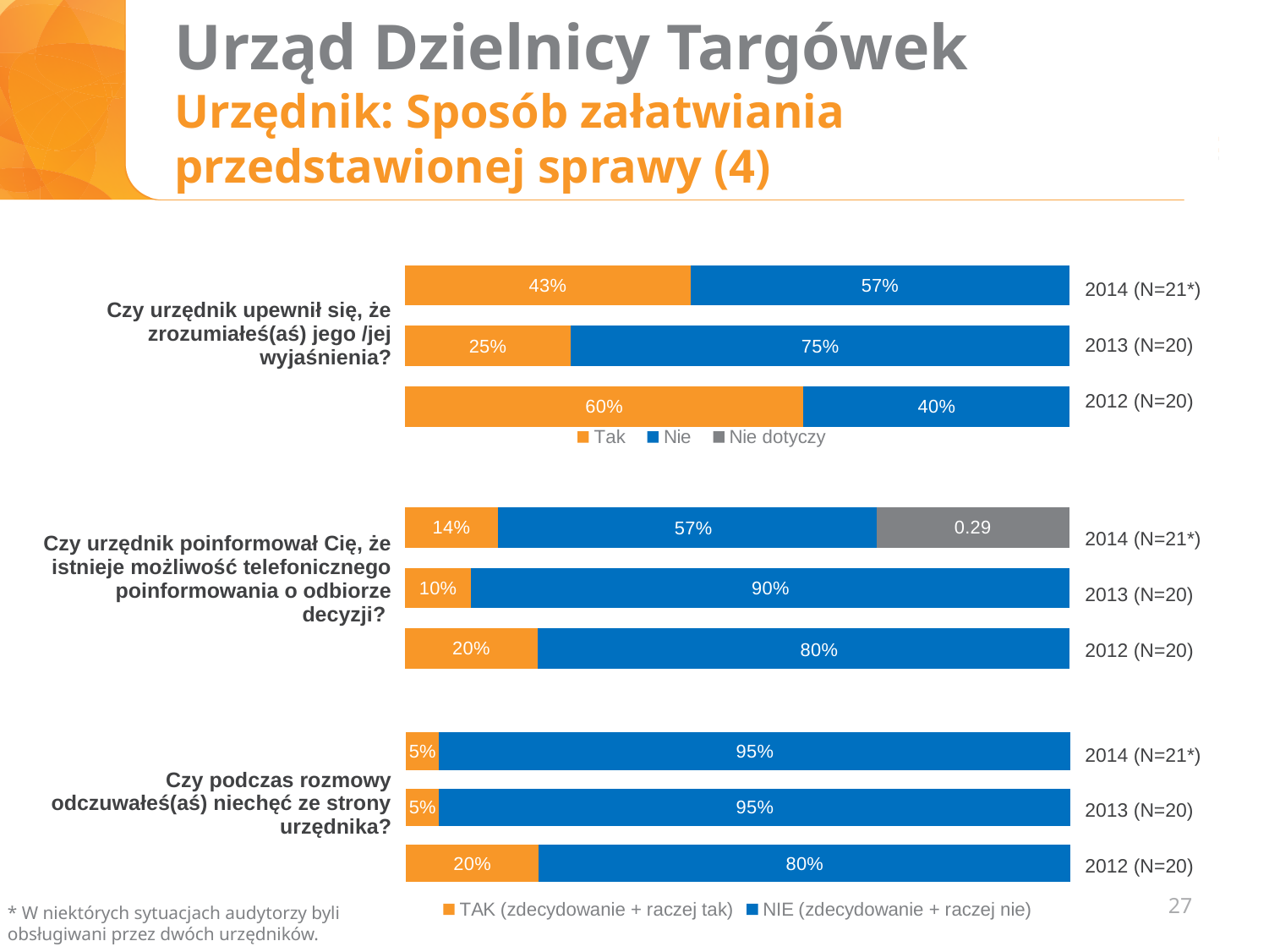
In the bottom chart ("Czy podczas rozmowy odczuwałeś(aś) niechęć ze strony urzędnika?"), what is the "TAK" value for 2012 (N=20)? 20% In the middle chart, what value is printed on the grey "Nie dotyczy" segment for 2014 (N=21*)? 0.29 In the middle chart ("Czy urzędnik poinformował Cię, że istnieje możliwość telefonicznego poinformowania o odbiorze decyzji?"), what is the "Nie" value for 2013 (N=20)? 90% What type of chart is used on this slide? Stacked bar chart In the top chart ("Czy urzędnik upewnił się, że zrozumiałeś(aś) jego /jej wyjaśnienia?"), what is the "Tak" value for 2014 (N=21*)? 43% In the middle chart, which year has the lowest "Tak" value? 2013 (N=20) In the top chart, which year has the highest "Tak" value? 2012 (N=20) In the top chart, what is the "Nie" value for 2013 (N=20)? 75% How many series does the legend of the top chart list? 3 In the top chart, what is the difference between the "Tak" values for 2012 and 2013? 35 percentage points How many bars (years) are shown in the bottom chart? 3 In the bottom chart, is the "NIE" value for 2014 larger or smaller than the "NIE" value for 2012? larger